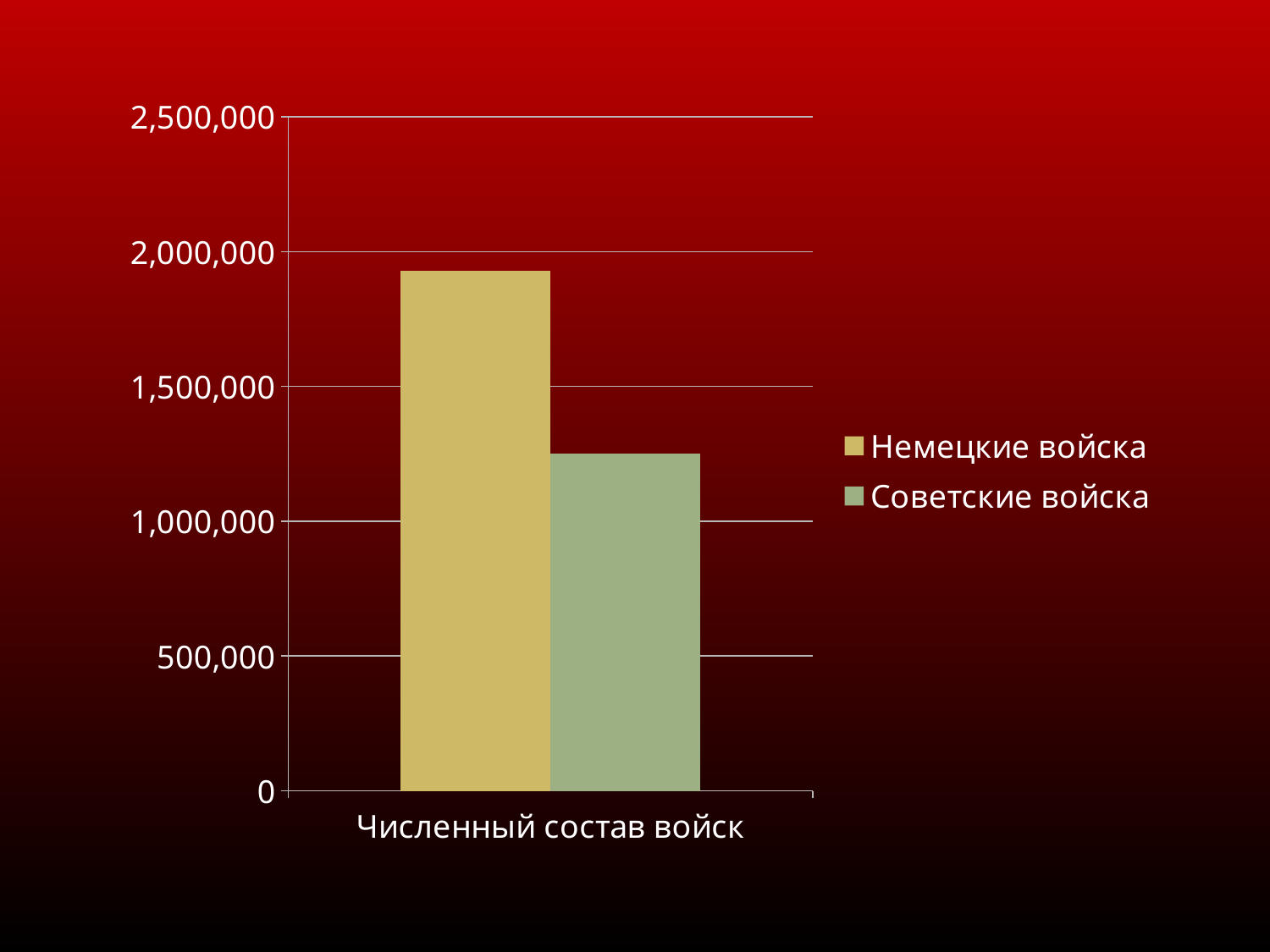
What is the highest value shown on the y axis? 2,500,000 Is the value for Советские войска greater or less than 1,000,000? greater Is the value for Советские войска greater or less than 1,500,000? less Which series has the higher value for Численный состав войск: Немецкие войска or Советские войска? Немецкие войска Is the value for Немецкие войска greater or less than 1,500,000? greater How many series does the legend list? 2 What is the label of the category on the x axis? Численный состав войск Which series has the tallest bar? Немецкие войска What kind of chart is shown on the slide? bar chart How many categories are shown on the x axis? 1 Which series has the shortest bar? Советские войска